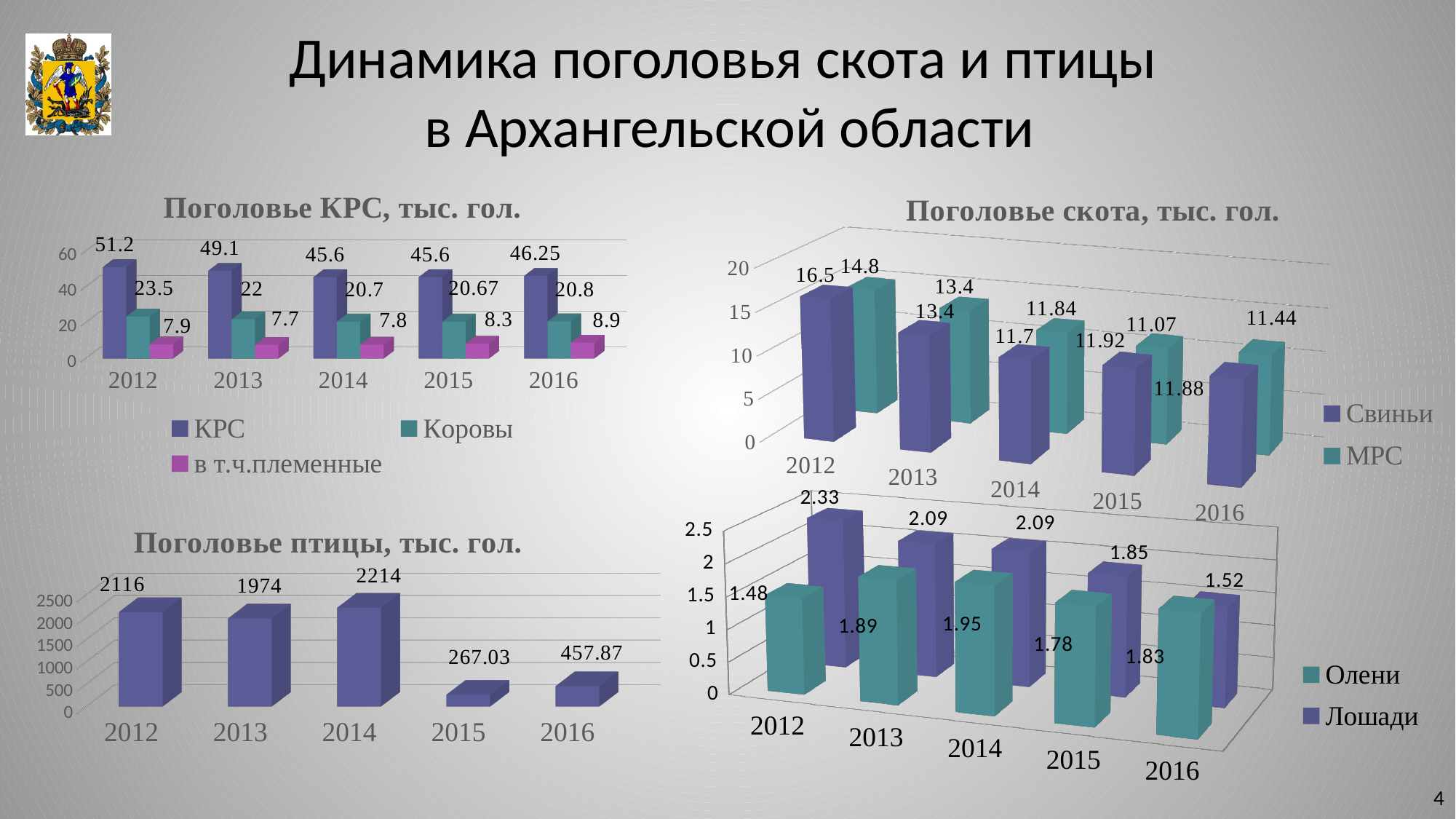
In the chart 'Поголовье птицы, тыс. гол.', what is the value for 2014? 2214 What kind of chart is 'Поголовье птицы, тыс. гол.'? bar chart In the chart 'Поголовье птицы, тыс. гол.', which year has the lowest value? 2015 In the chart 'Поголовье птицы, тыс. гол.', is the value for 2013 greater or less than 1500? greater In the chart 'Поголовье КРС, тыс. гол.', what is the difference between the КРС values for 2012 and 2013? 2.1 In the chart 'Поголовье КРС, тыс. гол.', what is the value for КРС in 2012? 51.2 In the chart 'Поголовье скота, тыс. гол.', which is larger in 2012: Свиньи or МРС? Свиньи In the chart 'Поголовье КРС, тыс. гол.', which year has the highest value for 'в т.ч.племенные'? 2016 How many series does the legend of the chart 'Поголовье КРС, тыс. гол.' list? 3 How many years are shown on the x axis of the bottom-right chart (Олени and Лошади)? 5 In the bottom-right chart (Олени and Лошади), what is the value for Лошади in 2012? 2.33 In the chart 'Поголовье скота, тыс. гол.', what is the value for Свиньи in 2012? 16.5